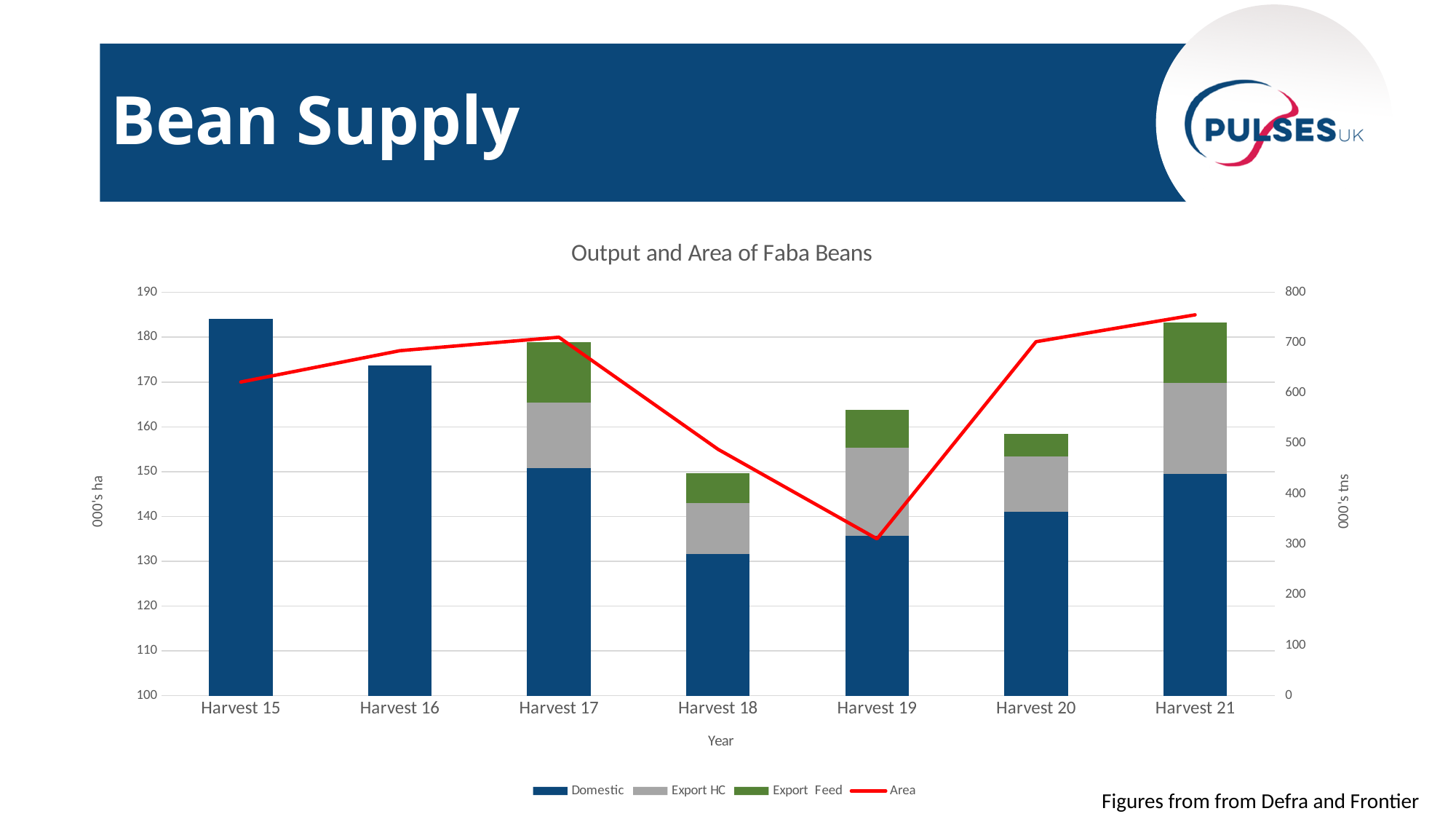
Does the Area line rise or fall from Harvest 17 to Harvest 19? fall Which harvest has the lowest value on the Area line? Harvest 19 Is the total bar for Harvest 15 greater or less than 180 on the left axis? greater Which harvest has the highest value on the Area line? Harvest 21 What kind of chart is this? Stacked bar chart with a line How many series does the chart legend list? 4 What is the title of the chart? Output and Area of Faba Beans Which has the larger total bar, Harvest 16 or Harvest 18? Harvest 16 Which harvest has the lowest total stacked bar? Harvest 18 Is the Area value for Harvest 19 greater or less than 400 on the right axis? less Is the total bar for Harvest 20 greater or less than 160 on the left axis? less How many harvest years are shown on the x axis? 7